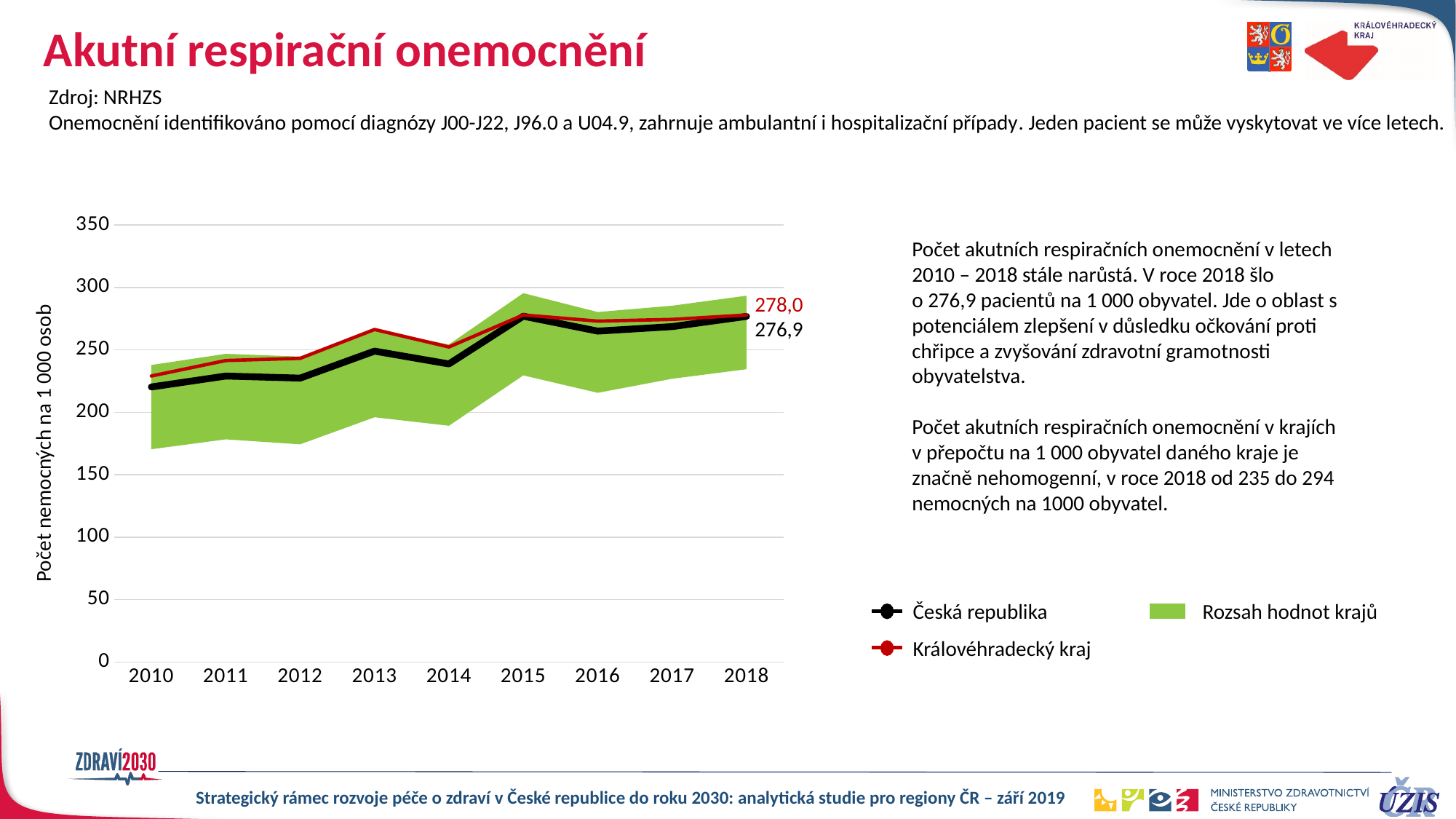
What is the value for Česká republika in 2018? 276,9 How many entries does the legend list? 3 Is the value for Česká republika in 2010 greater or less than 250? less What is the label of the y axis? Počet nemocných na 1 000 osob In 2018, which is larger: the value for Královéhradecký kraj or for Česká republika? Královéhradecký kraj Is the value for Královéhradecký kraj in 2015 greater or less than 250? greater What kind of chart is shown on the slide? combination area and line chart (lines with a shaded range band) What is the difference between the 2018 values for Královéhradecký kraj and Česká republika? 1,1 Does the Česká republika line generally rise or fall from 2010 to 2018? rise What is the value for Královéhradecký kraj in 2018? 278,0 Is the value for Česká republika in 2013 greater or less than 300? less How many years are shown on the x axis? 9